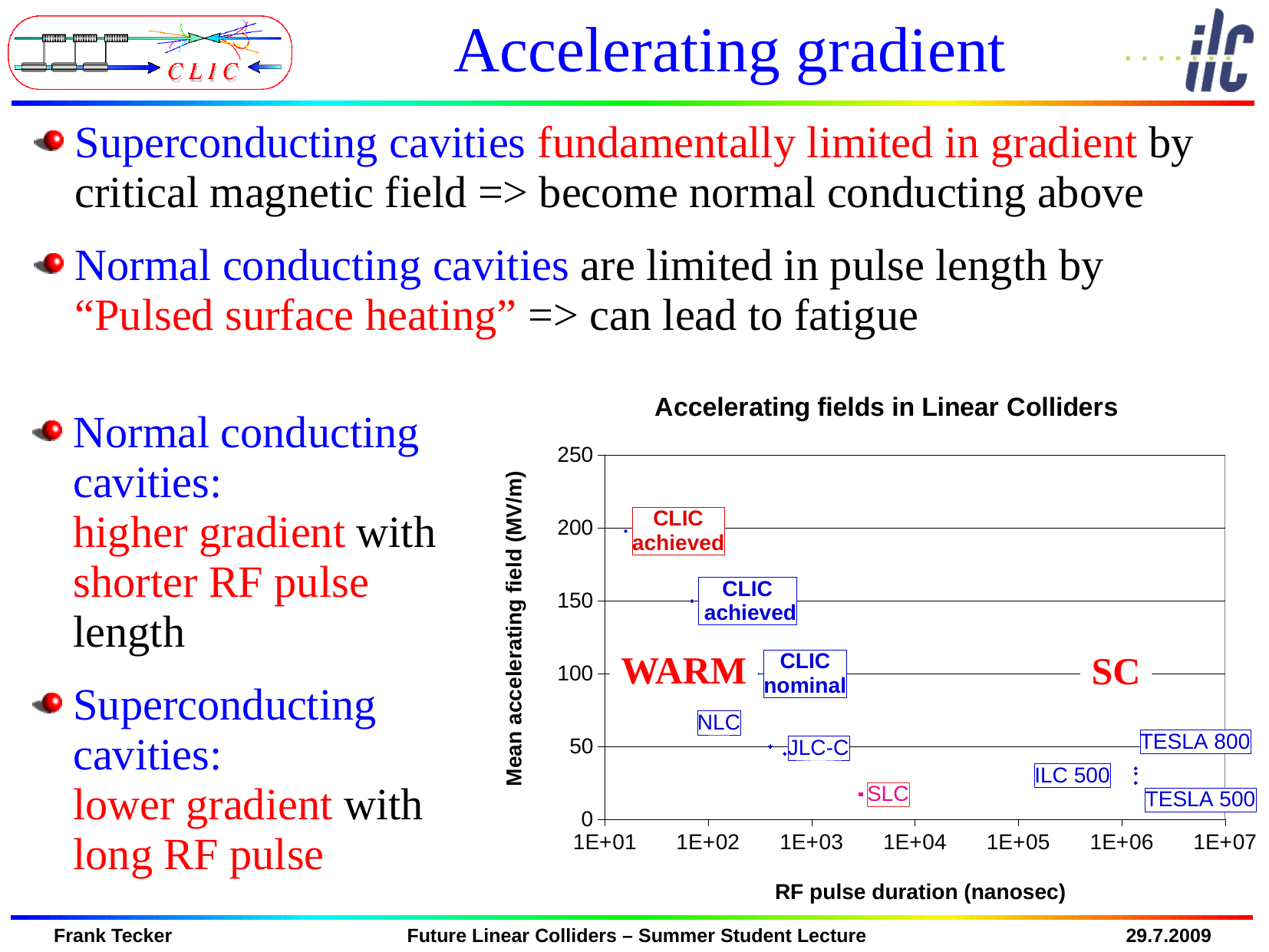
What kind of chart is shown on the slide? scatter chart Is the mean accelerating field for TESLA 800 greater or less than 100 MV/m? less Is the mean accelerating field for CLIC nominal greater or less than 50 MV/m? greater Is the mean accelerating field for SLC greater or less than 50 MV/m? less Which has the larger mean accelerating field, CLIC nominal or JLC-C? CLIC nominal Which labelled point has the highest mean accelerating field? CLIC achieved What is the highest tick value shown on the x axis? 1E+07 What is the label of the x axis of the chart? RF pulse duration (nanosec) Which has the larger mean accelerating field, NLC or ILC 500? NLC What is the title of the chart? Accelerating fields in Linear Colliders As RF pulse duration increases along the x axis, does the mean accelerating field generally rise or fall? fall